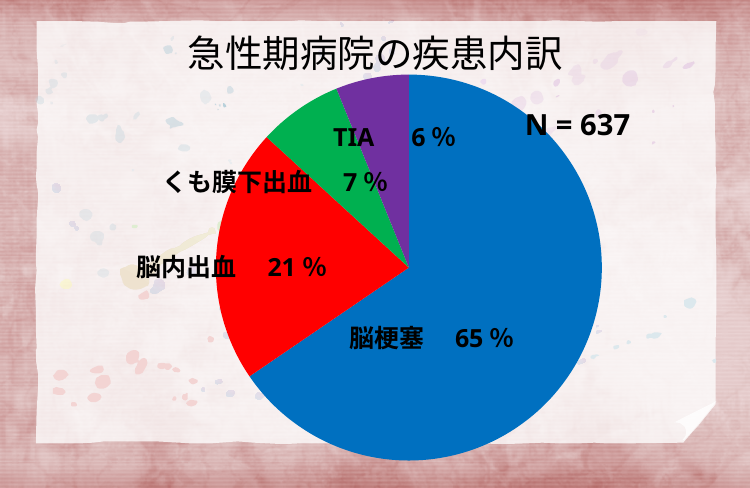
What is the value shown for くも膜下出血? 7 % What is the value shown for 脳梗塞? 65 % What is the title of the chart? 急性期病院の疾患内訳 What is the value shown for TIA? 6 % Which category has the largest share of the pie? 脳梗塞 What is the N value shown on the chart? N = 637 What kind of chart is shown on the slide? pie chart What is the difference between the shares of 脳梗塞 and 脳内出血? 44 % Which category has the smallest share of the pie? TIA How many slices does the pie chart have? 4 What is the value shown for 脳内出血? 21 % Which is larger, the share of くも膜下出血 or the share of TIA? くも膜下出血